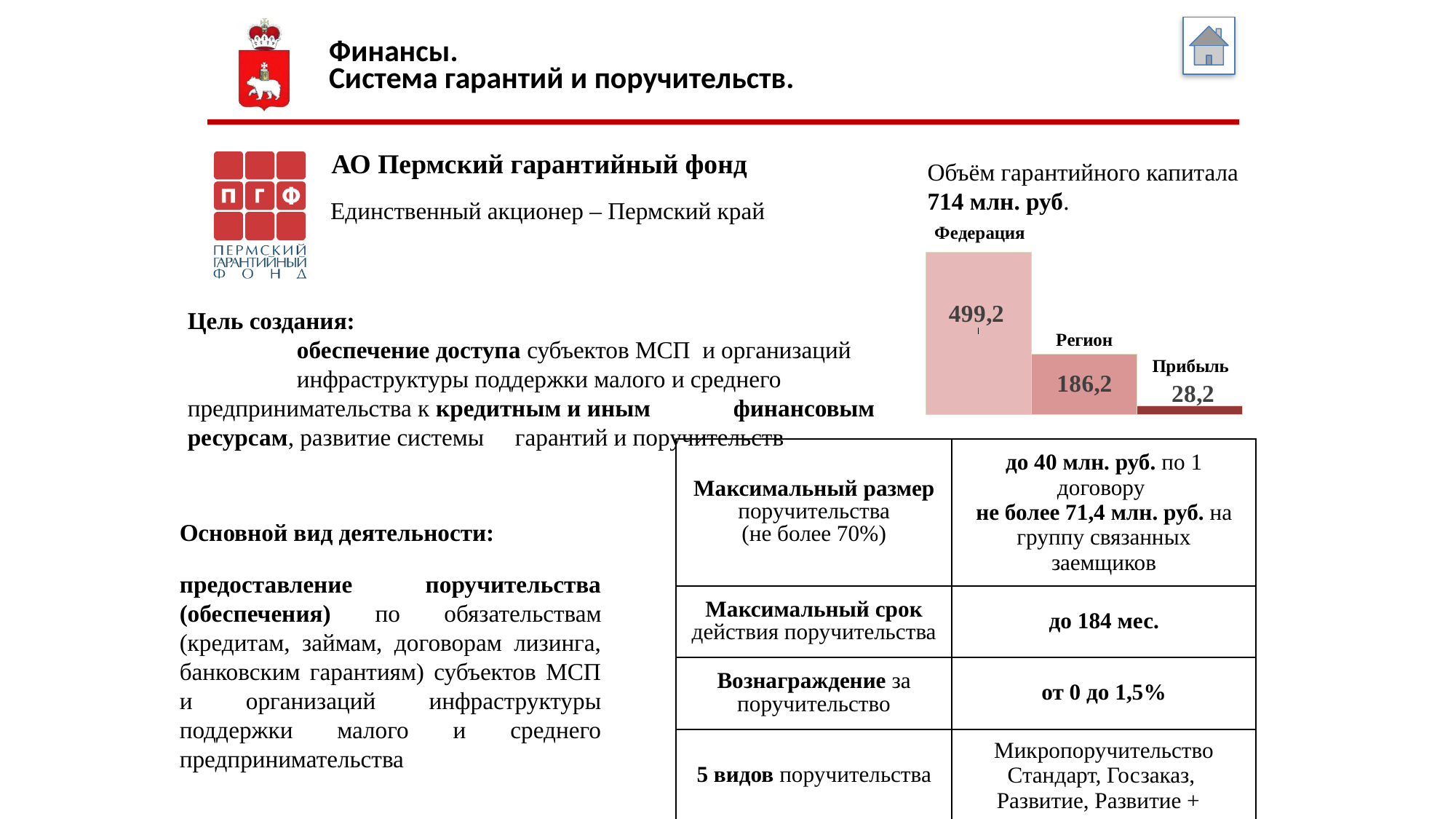
What is the value shown for Прибыль in the chart? 28,2 What is the value shown for Федерация in the chart? 499,2 What is the difference between the values for Федерация and Прибыль? 471,0 How many categories are shown in the chart? 3 What kind of chart is shown on the slide? Bar chart What is the difference between the values for Регион and Прибыль? 158,0 Which category has the lowest value in the chart? Прибыль What is the value shown for Регион in the chart? 186,2 Do the bar values rise or fall from left to right across the chart? Fall What is the difference between the values for Федерация and Регион? 313,0 Which category has the highest value in the chart? Федерация Which is larger, the value for Регион or the value for Прибыль? Регион